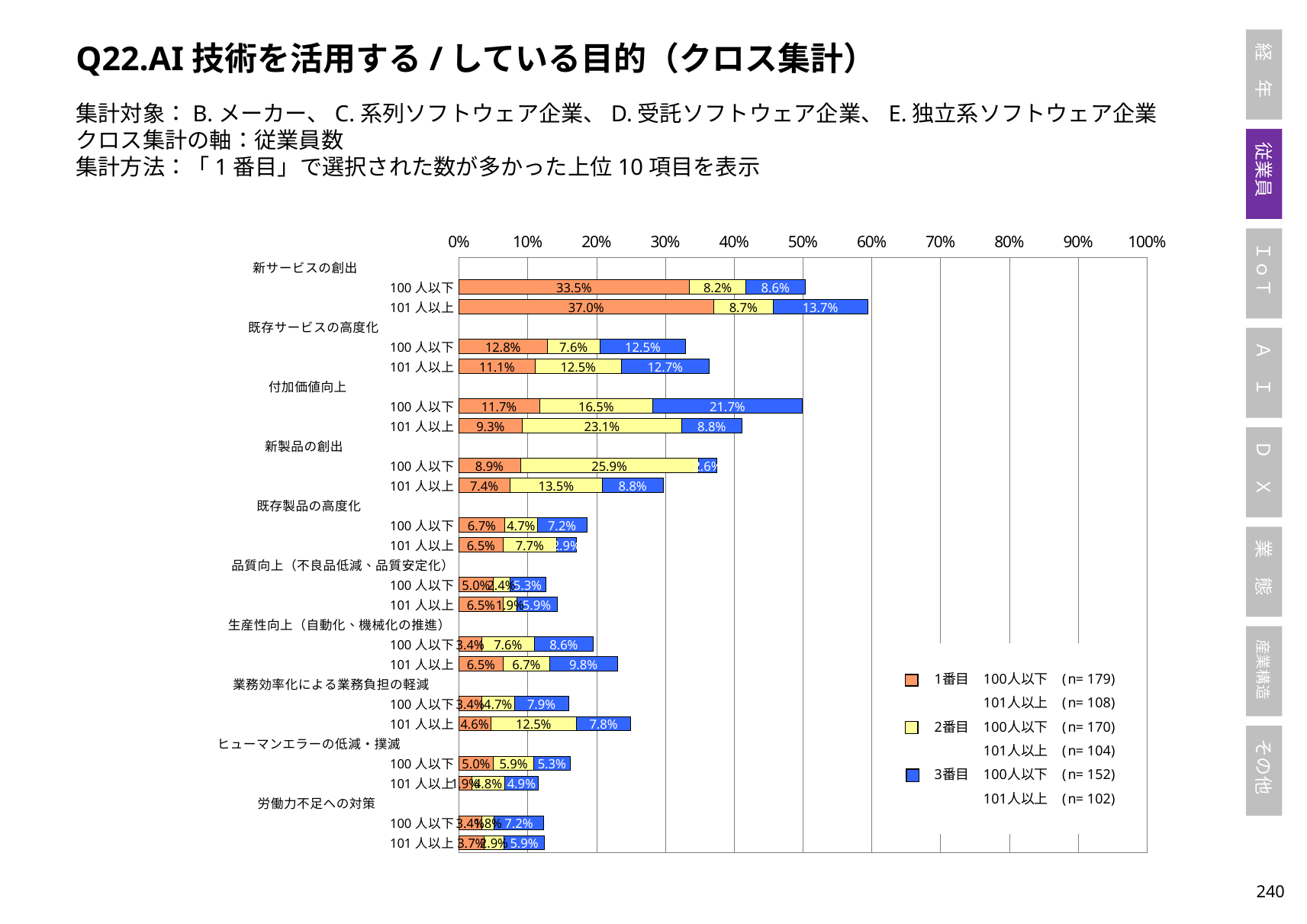
What is the 1番目 value for 新サービスの創出 among 101人以上 companies? 37.0% How many series does the legend list? 3 Which bar has the highest 1番目 value? 新サービスの創出, 101人以上 What is the total of the stacked bar for 新サービスの創出, 101人以上? 59.4% Is the total stacked bar for 新サービスの創出, 101人以上 greater or less than 50%? greater What is the 2番目 value for 新製品の創出 among 100人以下 companies? 25.9% What is the 3番目 value for 付加価値向上 among 100人以下 companies? 21.7% What is the 2番目 value for 業務効率化による業務負担の軽減 among 101人以上 companies? 12.5% How many purpose categories are shown on the chart? 10 What is the difference between the 1番目 values for 新サービスの創出 for 101人以上 and 100人以下? 3.5 percentage points For 新サービスの創出, which group has the larger 3番目 value, 100人以下 or 101人以上? 101人以上 What kind of chart is shown on the slide? bar chart